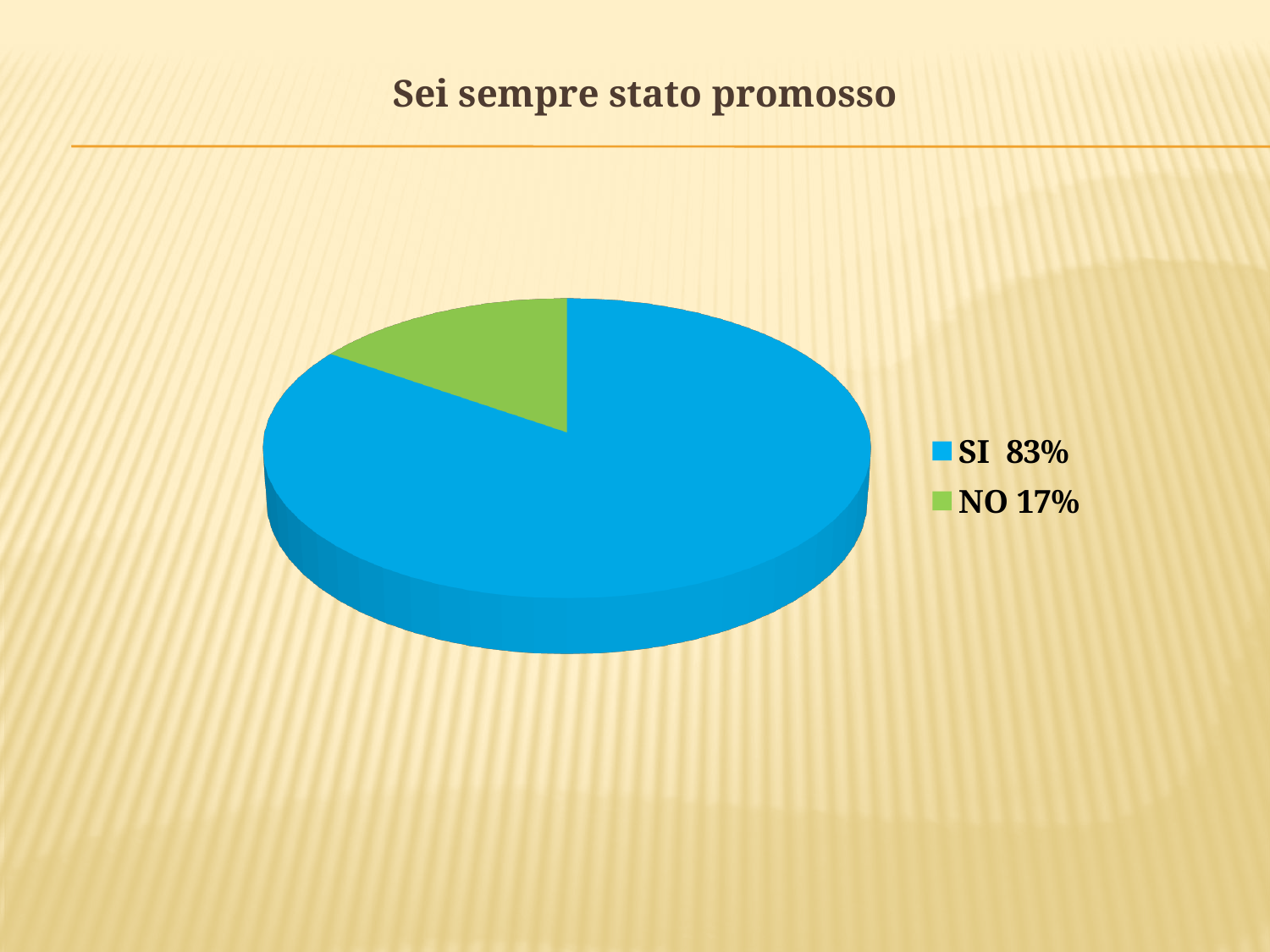
What is the title of the chart? Sei sempre stato promosso What colour is the slice for NO? green Which is larger, the share for SI or the share for NO? SI What kind of chart is shown on the slide? pie chart What share of the pie does NO represent? 17% How many entries does the legend list? 2 What is the difference in percentage points between SI and NO? 66 How many categories are shown in the pie chart? 2 Which category has the smallest slice of the pie? NO What share of the pie does SI represent? 83% Which category has the largest slice of the pie? SI